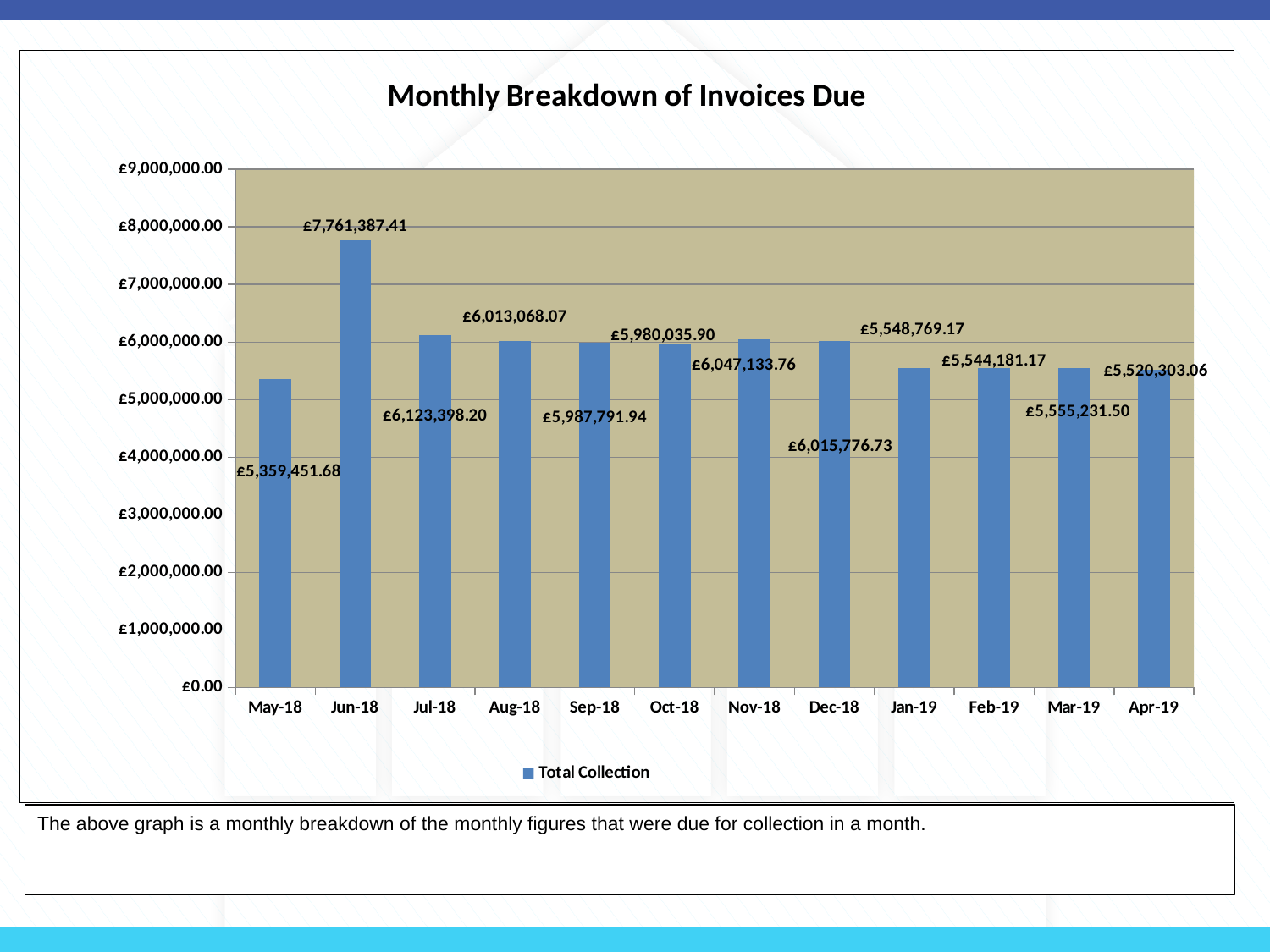
Is the value for Jun-18 greater or less than £7,000,000.00? greater Which month has the highest value? Jun-18 Which is larger, the value for Jul-18 or the value for Aug-18? Jul-18 What is the difference between the values for Jun-18 and May-18? £2,401,935.73 What is the value for May-18? £5,359,451.68 What is the value for Jun-18? £7,761,387.41 What kind of chart is shown? bar chart What is the value for Apr-19? £5,520,303.06 What is the value for Nov-18? £6,047,133.76 How many months are shown on the x axis? 12 Which month has the lowest value? May-18 How many series does the legend list? 1